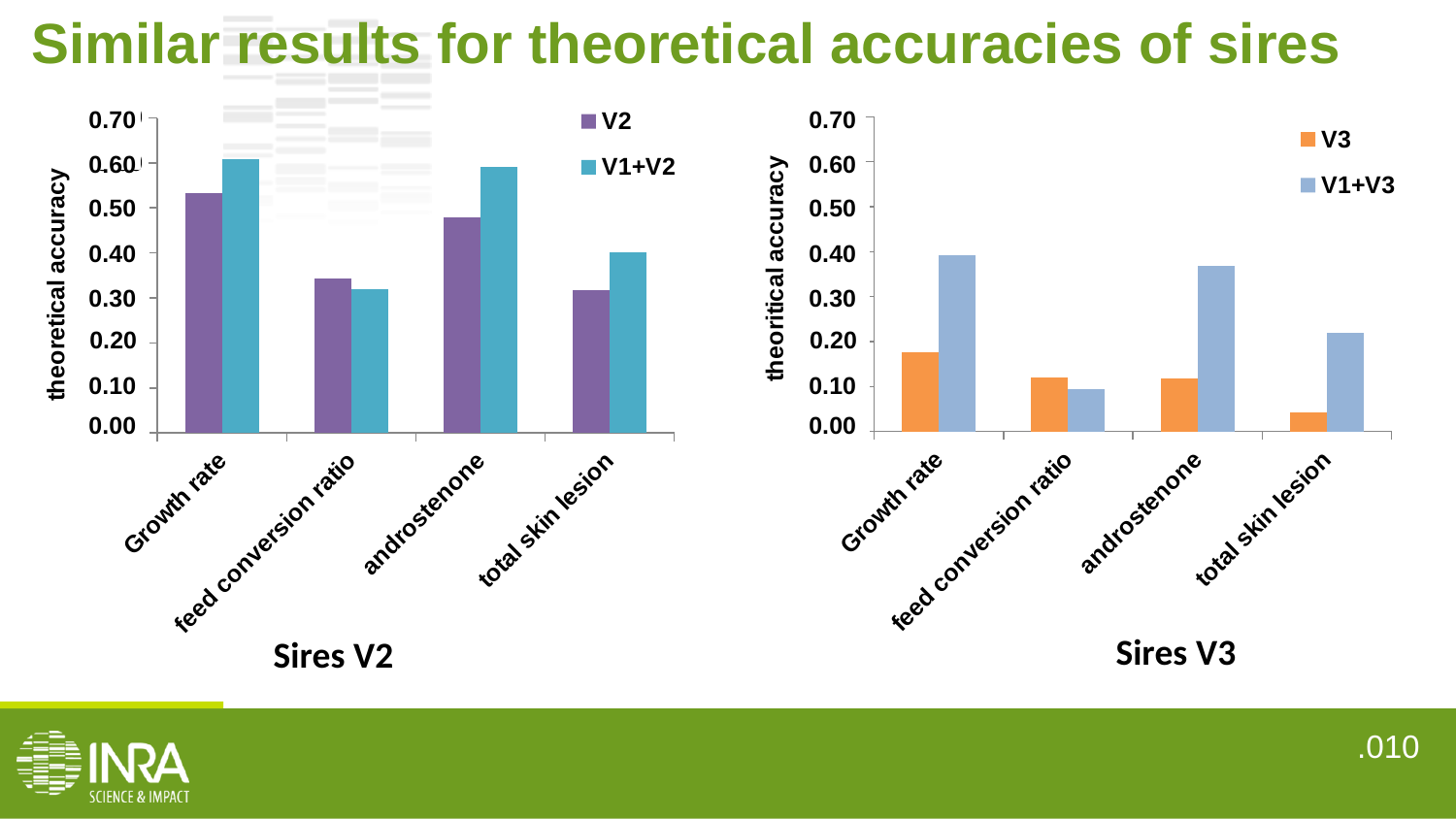
What kind of chart is the Sires V2 chart on the left? bar chart On the Sires V3 chart (right), which category has the lowest V3 value? total skin lesion On the Sires V2 chart (left), how many series does the legend list? 2 On the Sires V3 chart (right), how many series does the legend list? 2 On the Sires V2 chart (left), is the V2 value for Growth rate greater or less than 0.50? greater On the Sires V2 chart (left), how many categories are shown on the x axis? 4 On the Sires V3 chart (right), which series has the larger value for feed conversion ratio, V3 or V1+V3? V3 On the Sires V3 chart (right), is the V3 value for total skin lesion greater or less than 0.10? less On the Sires V2 chart (left), which series has the larger value for androstenone, V2 or V1+V2? V1+V2 On the Sires V3 chart (right), is the V1+V3 value for Growth rate greater or less than 0.30? greater On the Sires V2 chart (left), which category has the highest V2 value? Growth rate